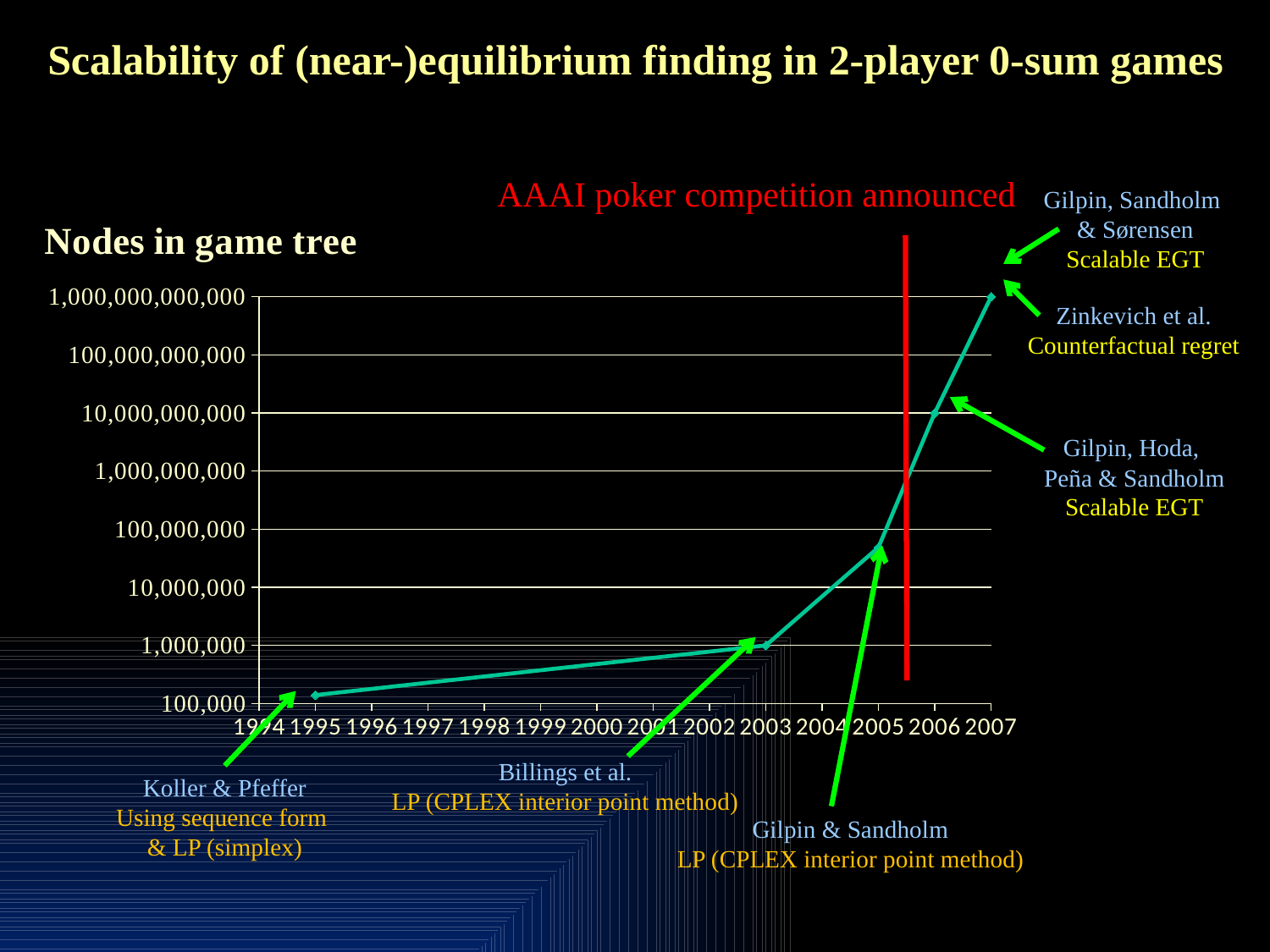
What is the title of the slide's chart? Nodes in game tree Is the value for 1995 greater or less than 1,000,000? less Is the value for 2006 greater or less than 1,000,000,000? greater Do the values on the chart rise or fall from 1994 to 2007? rise What quantity does the y axis of the chart represent? Nodes in game tree Is the value for 2007 greater or less than 100,000,000,000? greater What kind of chart is shown on the slide? line chart Which year has the highest number of nodes in the game tree on the chart? 2007 Which is larger, the value for 2003 or the value for 2006? 2006 Which year has the lowest number of nodes in the game tree on the chart? 1995